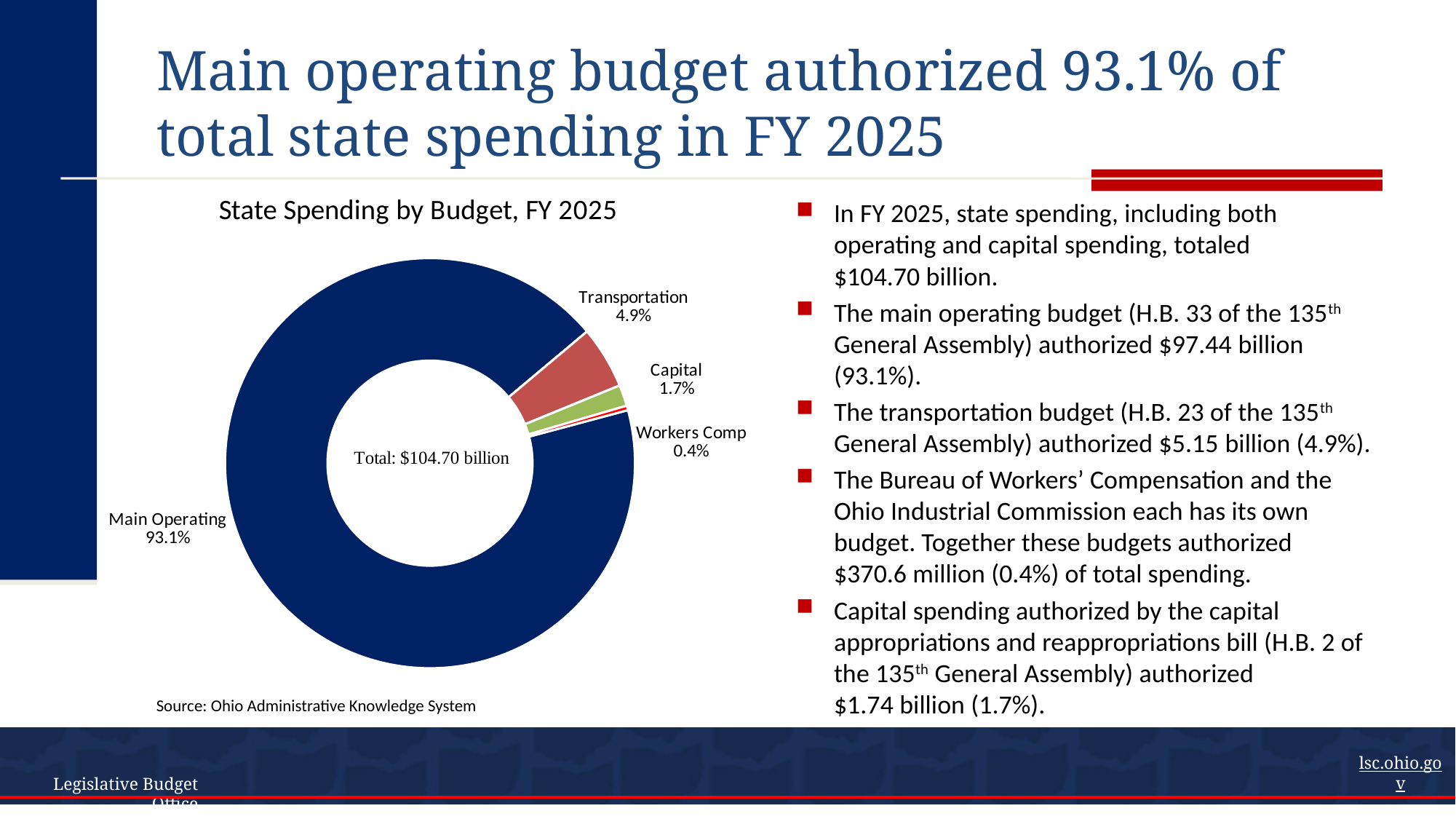
Which budget category has the largest share in the chart? Main Operating How many budget categories are shown in the chart? 4 Which budget category has the smallest share in the chart? Workers Comp What is the difference in percentage points between the Transportation and Capital shares? 3.2 What share of state spending does Workers Comp account for in the chart? 0.4% What kind of chart is shown on the slide? Pie chart (doughnut) What share of state spending does Transportation account for in the chart? 4.9% Which has a larger share, Capital or Workers Comp? Capital What is the title of the chart? State Spending by Budget, FY 2025 What total is printed in the center of the chart? Total: $104.70 billion What share of state spending does Capital account for in the chart? 1.7%